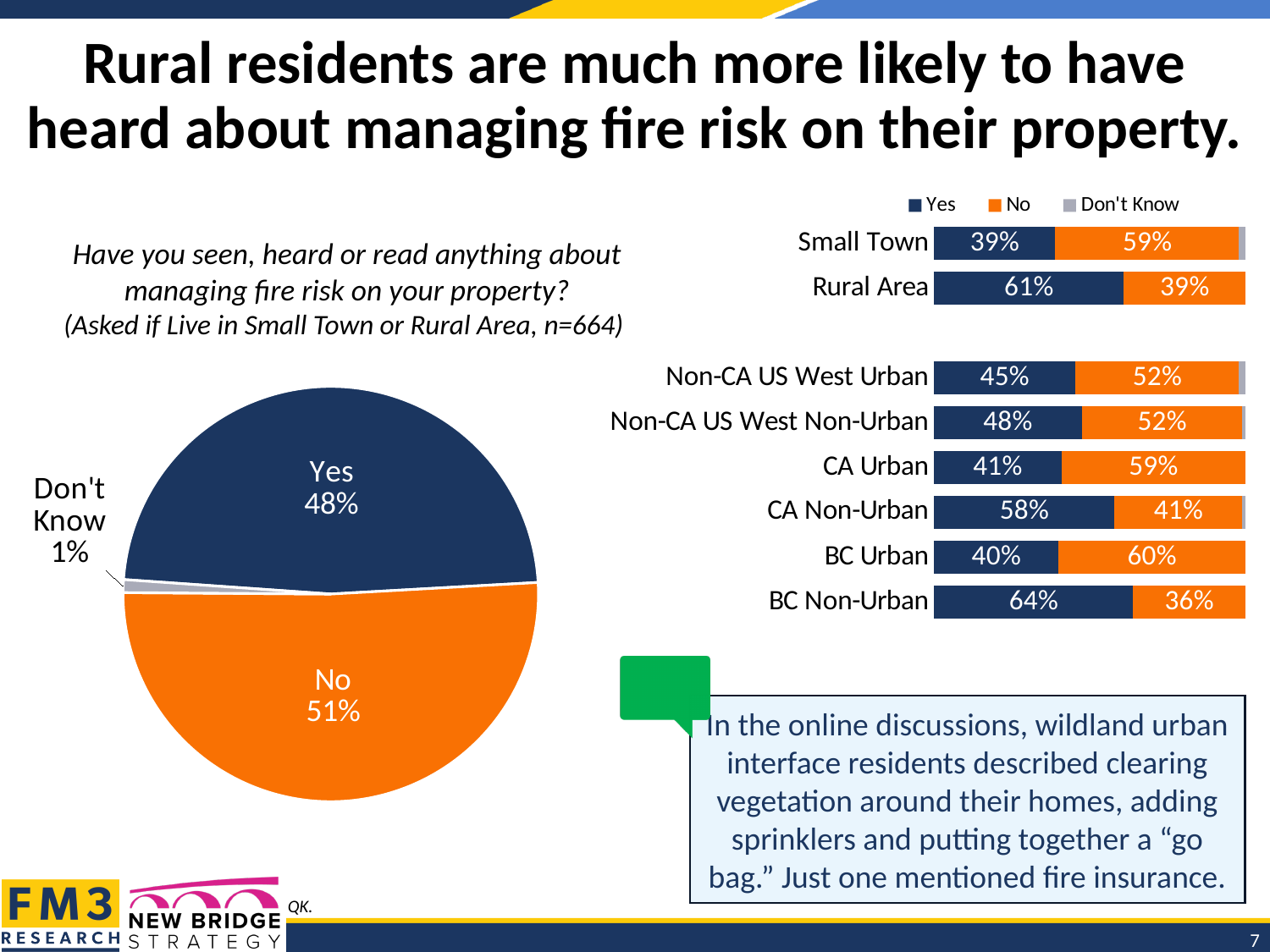
How many categories are shown in the stacked bar chart? 8 In the stacked bar chart, which category has the highest "Yes" percentage? BC Non-Urban In the stacked bar chart, which has a higher "Yes" percentage, CA Urban or CA Non-Urban? CA Non-Urban In the pie chart, which response has the largest slice? No In the stacked bar chart, what percentage of Rural Area respondents answered "Yes"? 61% In the pie chart, what is the difference between the "No" share and the "Yes" share? 3 percentage points In the stacked bar chart, what percentage of Small Town respondents answered "No"? 59% How many series does the legend of the stacked bar chart list? 3 In the stacked bar chart, which category has the lowest "Yes" percentage? Small Town In the pie chart, what share of respondents answered "Don't Know"? 1% In the stacked bar chart, what is the difference between the "Yes" percentages for Rural Area and Small Town? 22 percentage points In the pie chart, what share of respondents answered "Yes"? 48%